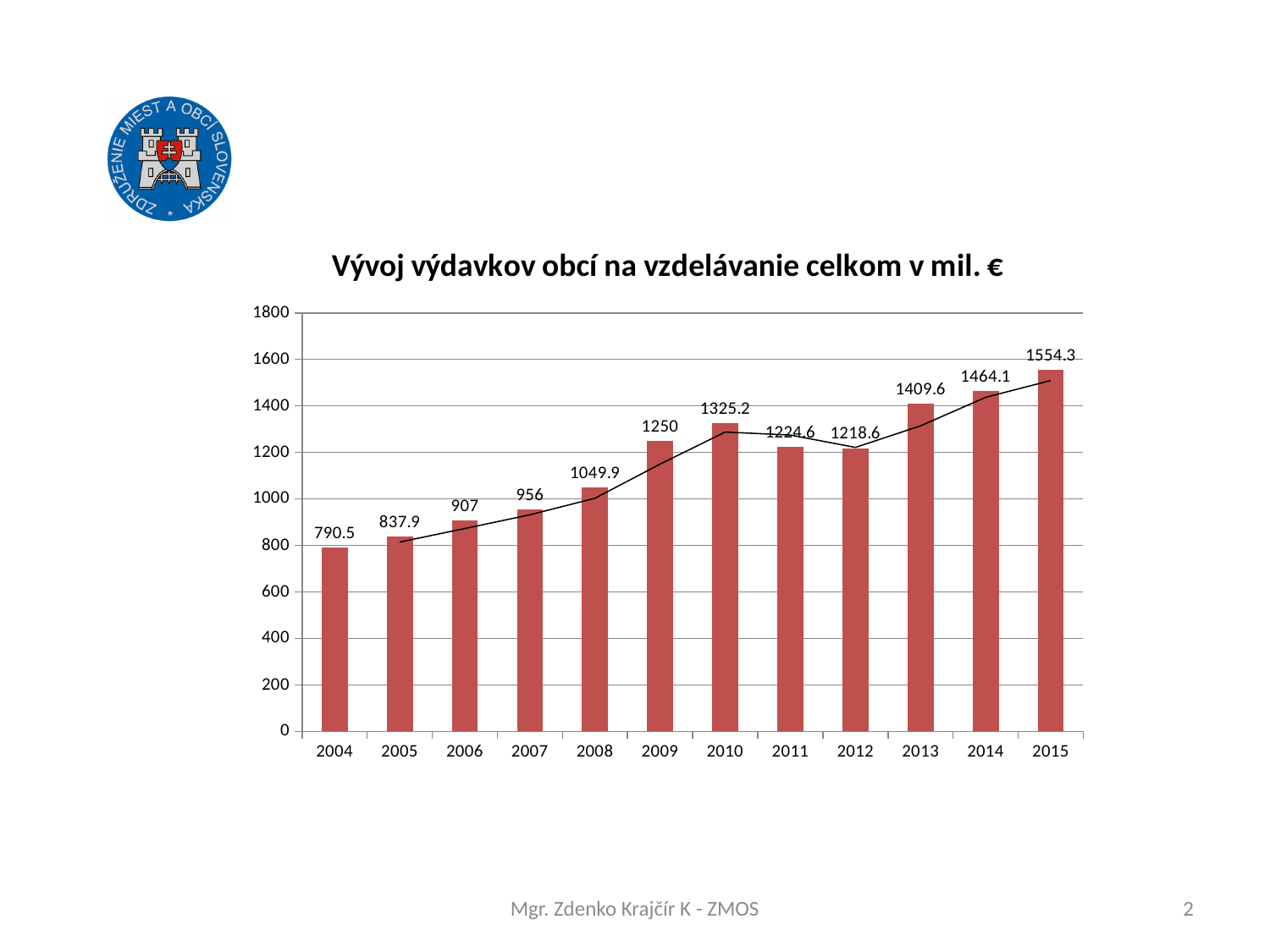
Which is larger, the value for 2011 or the value for 2012? 2011 What is the difference between the values for 2010 and 2011? 100.6 Which year has the lowest value? 2004 What is the difference between the values for 2015 and 2014? 90.2 What is the value for 2004? 790.5 What is the value for 2012? 1218.6 What is the title of the chart? Vývoj výdavkov obcí na vzdelávanie celkom v mil. € How many years are shown on the x axis? 12 What is the value for 2010? 1325.2 What kind of chart is this? bar chart Which year has the highest value? 2015 Is the value for 2008 greater or less than 1000? greater